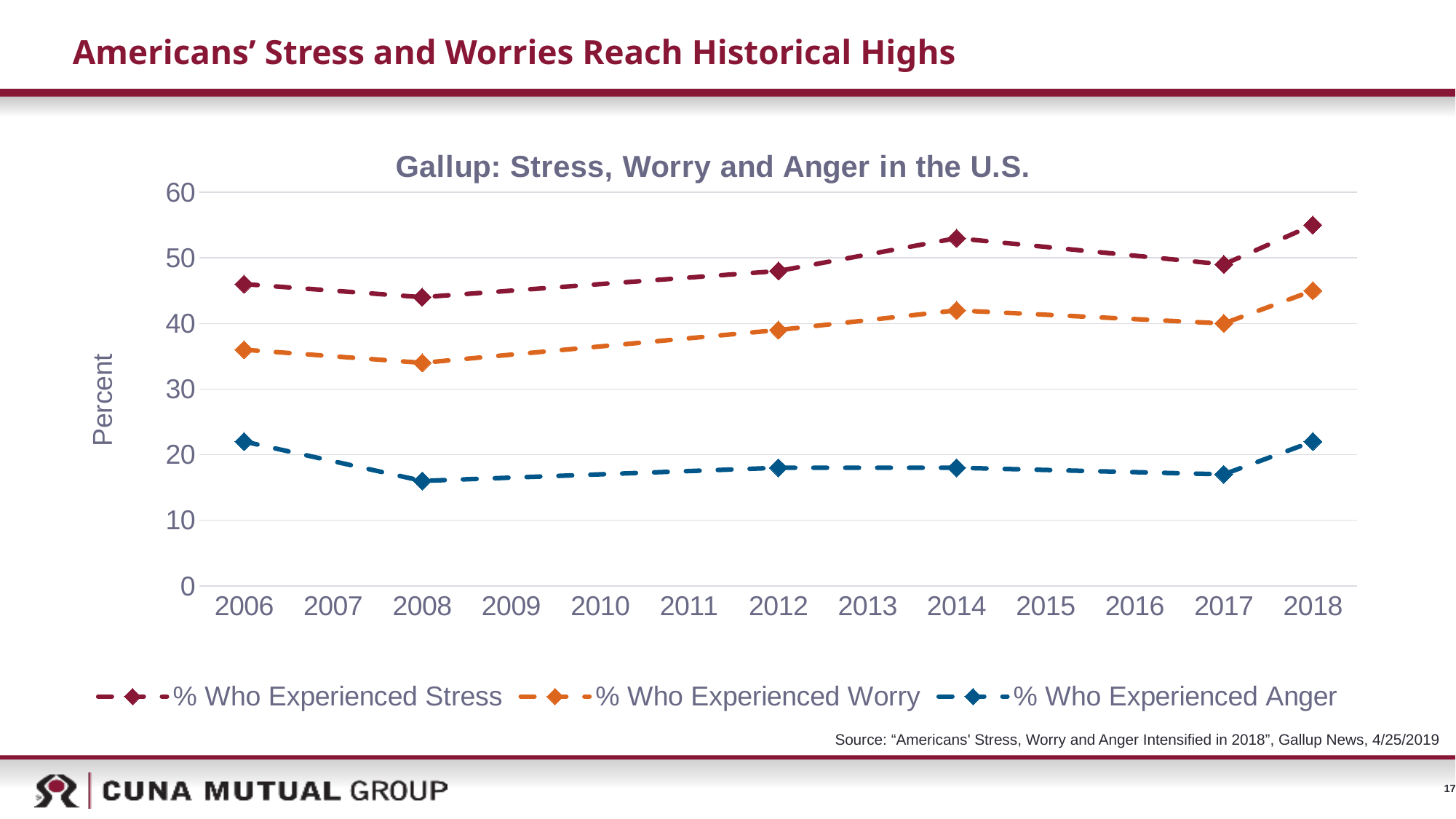
Which series has the higher value in 2018, % Who Experienced Stress or % Who Experienced Worry? % Who Experienced Stress How many data points are plotted for the % Who Experienced Stress series? 6 Is the value for % Who Experienced Stress in 2018 greater or less than 50? greater Is the value for % Who Experienced Worry in 2008 greater or less than 40? less What kind of chart is shown on the slide? Line chart How many series does the legend list? 3 What is the label on the vertical axis? Percent Is the value for % Who Experienced Anger in 2008 greater or less than 20? less What is the title of the chart? Gallup: Stress, Worry and Anger in the U.S. Does % Who Experienced Stress rise or fall from 2017 to 2018? Rise In which year is % Who Experienced Worry at its highest? 2018